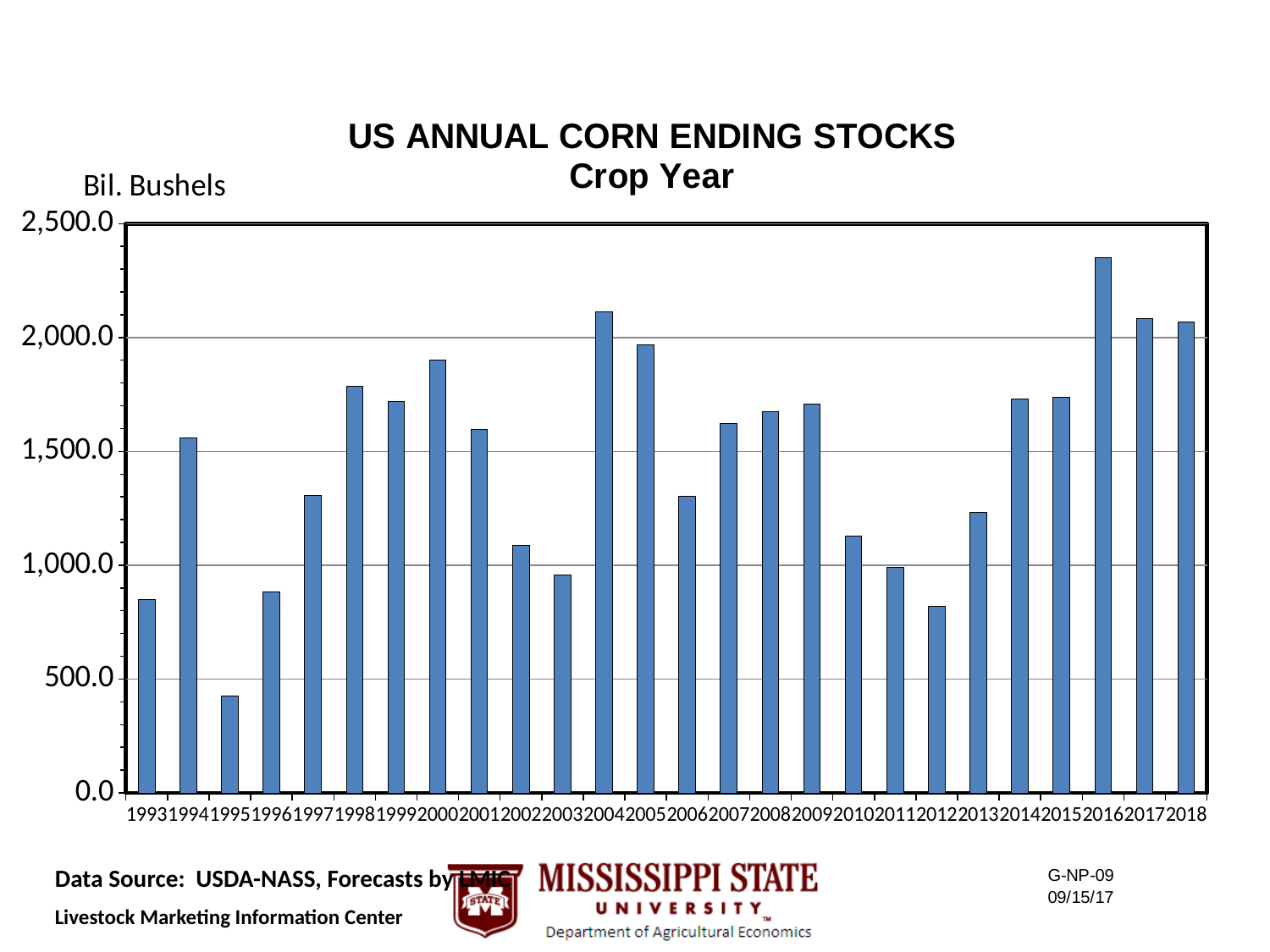
What kind of chart is shown on the slide? bar chart Is the value for 2012 greater or less than 1,000.0? less Is the value for 2016 greater or less than 2,000.0? greater Which crop year has the larger value, 2013 or 2014? 2014 Which crop year has the highest corn ending stocks? 2016 Is the value for 1995 greater or less than 500.0? less How many crop years are plotted on the chart? 26 Which crop year has the larger value, 2004 or 2005? 2004 Which crop year has the lowest corn ending stocks? 1995 What unit is shown on the vertical axis of the chart? Bil. Bushels Do the values rise or fall from 2012 to 2016? rise